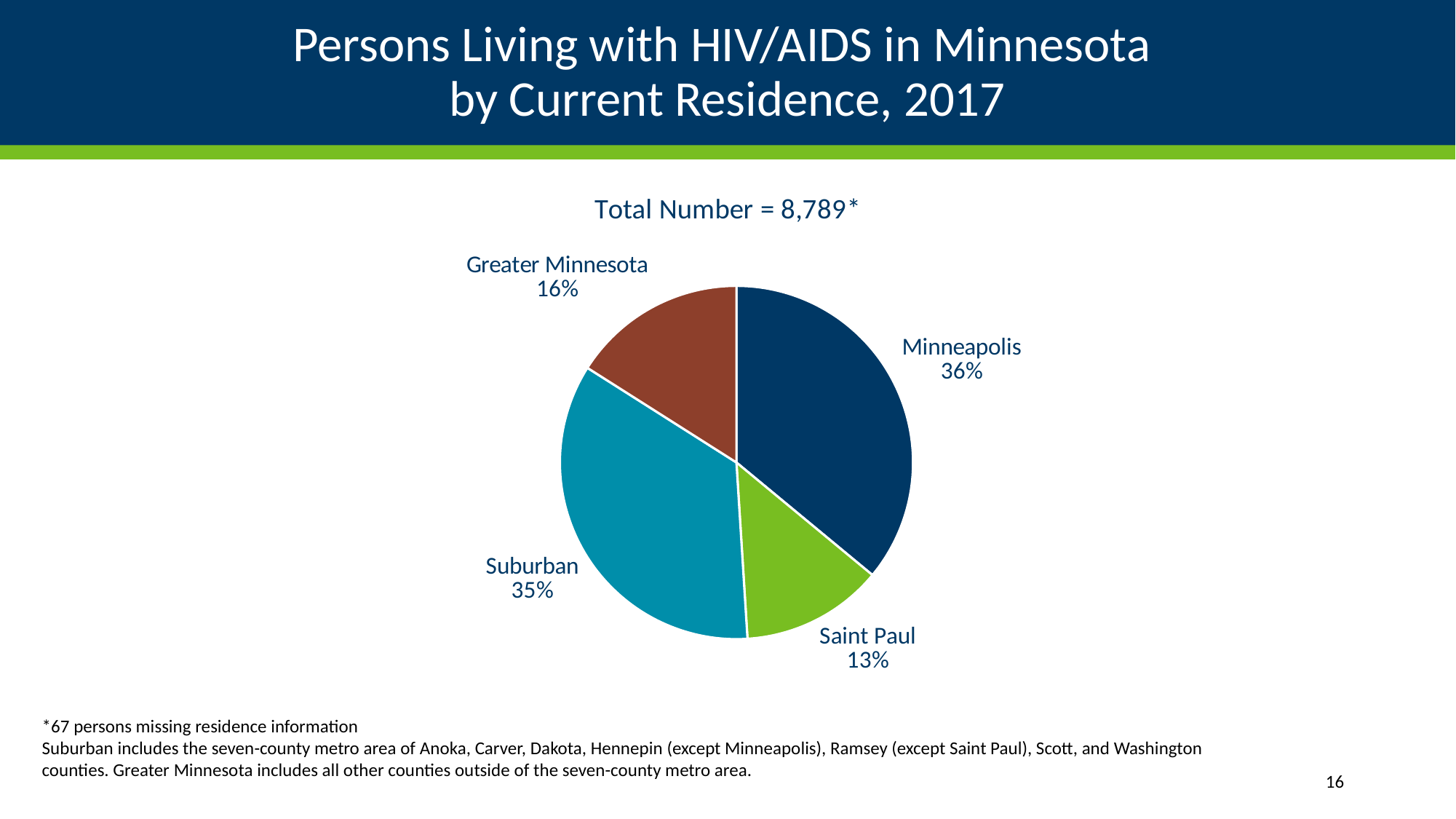
What percentage is shown for Greater Minnesota? 16% What kind of chart is shown on the slide? Pie chart What percentage of persons living with HIV/AIDS in Minnesota reside in Minneapolis? 36% Which residence category has the smallest share of the pie? Saint Paul What total number is stated above the pie chart? 8,789 What share of the pie is labelled Suburban? 35% What is the difference in percentage points between Minneapolis and Saint Paul? 23 Which is larger, the share for Suburban or the share for Greater Minnesota? Suburban What percentage is shown for Saint Paul? 13% How many residence categories are shown in the pie chart? 4 What is the difference in percentage points between Greater Minnesota and Saint Paul? 3 Which is larger, the share for Greater Minnesota or the share for Saint Paul? Greater Minnesota